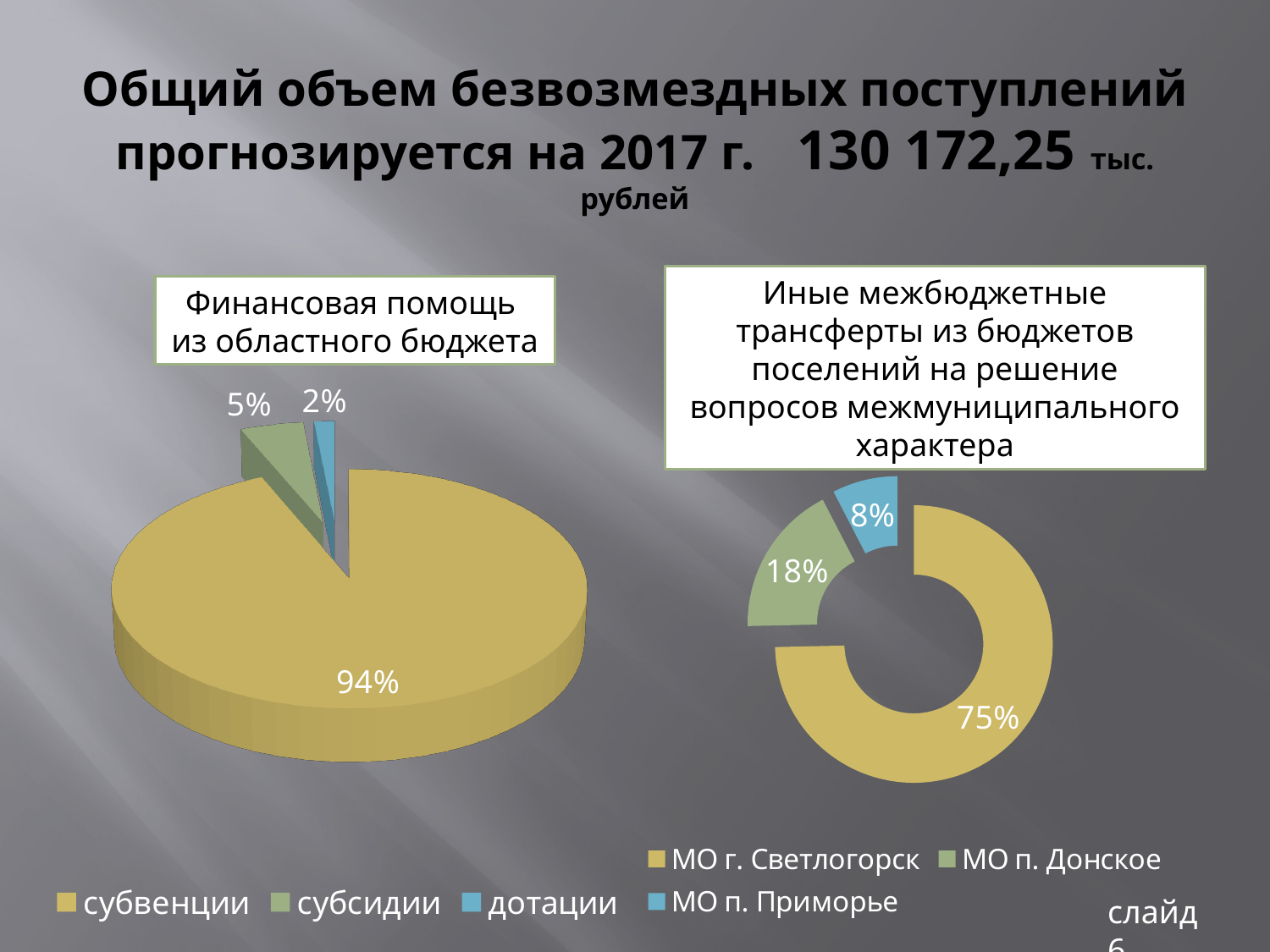
In the chart titled "Финансовая помощь из областного бюджета", how many categories does the legend list? 3 In the chart on the right (Иные межбюджетные трансферты), what share does МО п. Приморье have? 8% What type of chart is the chart on the left (Финансовая помощь из областного бюджета)? pie chart In the chart on the right (Иные межбюджетные трансферты), what share does МО п. Донское have? 18% In the chart titled "Финансовая помощь из областного бюджета", which category has the smallest share? дотации In the chart on the right (Иные межбюджетные трансферты), what share does МО г. Светлогорск have? 75% In the chart titled "Финансовая помощь из областного бюджета", what share do субвенции have? 94% In the chart titled "Финансовая помощь из областного бюджета", what share do дотации have? 2% In the chart on the right (Иные межбюджетные трансферты), which is larger: МО п. Донское or МО п. Приморье? МО п. Донское In the chart titled "Финансовая помощь из областного бюджета", what is the difference in percentage points between субсидии and дотации? 3 In the chart titled "Финансовая помощь из областного бюджета", what share do субсидии have? 5% In the chart on the right (Иные межбюджетные трансферты), which category has the largest share? МО г. Светлогорск